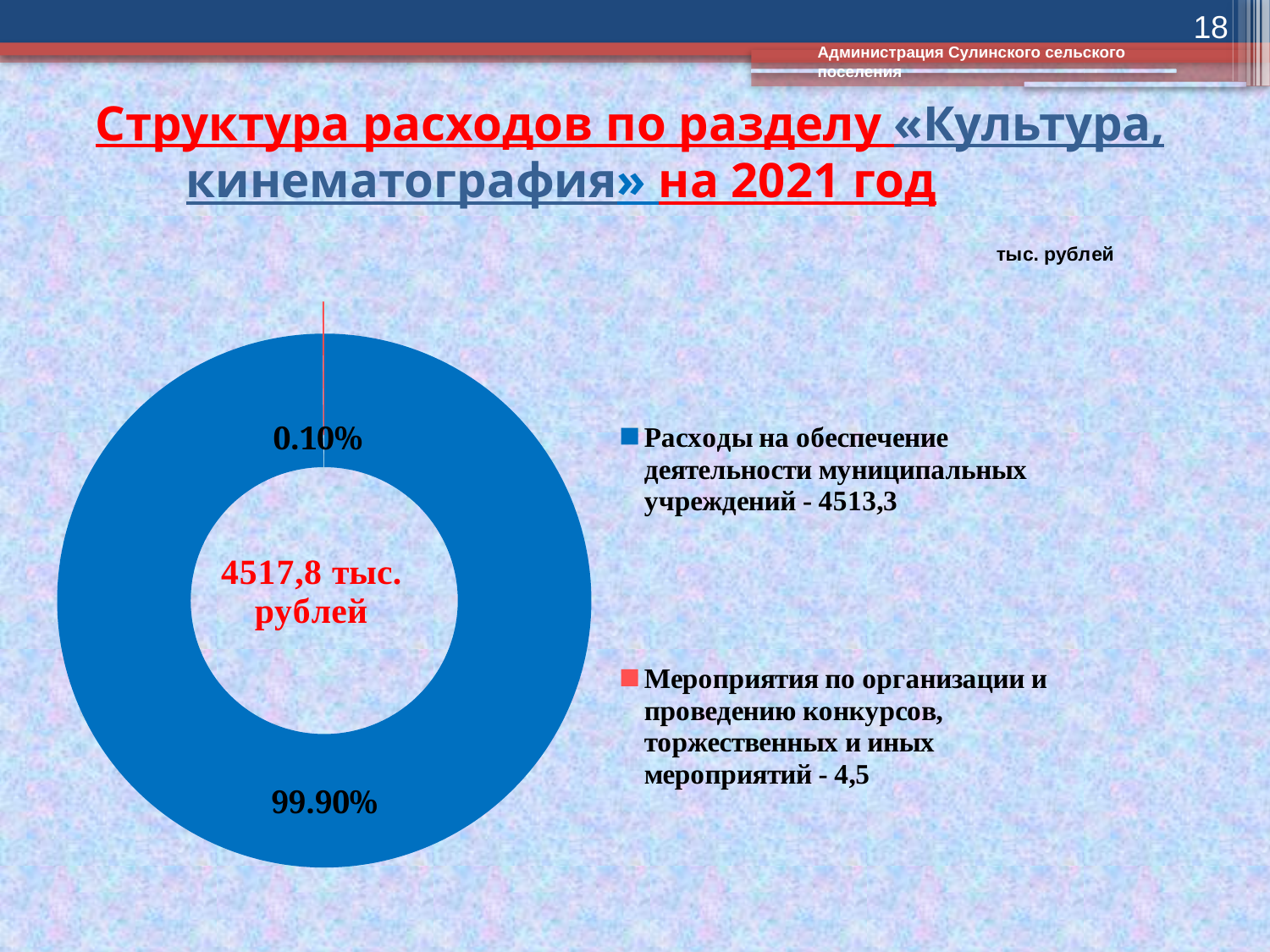
What share of the chart does "Расходы на обеспечение деятельности муниципальных учреждений" take? 99.90% How many categories does the chart's legend list? 2 What value is given in the legend for "Мероприятия по организации и проведению конкурсов, торжественных и иных мероприятий"? 4,5 What unit of measurement is indicated above the chart? тыс. рублей Which category has the largest share of the chart? Расходы на обеспечение деятельности муниципальных учреждений Which is larger: the value for "Расходы на обеспечение деятельности муниципальных учреждений" or for "Мероприятия по организации и проведению конкурсов, торжественных и иных мероприятий"? Расходы на обеспечение деятельности муниципальных учреждений What total amount is shown in the centre of the chart? 4517,8 тыс. рублей Which category has the smallest share of the chart? Мероприятия по организации и проведению конкурсов, торжественных и иных мероприятий What value is given in the legend for "Расходы на обеспечение деятельности муниципальных учреждений"? 4513,3 What share of the chart does "Мероприятия по организации и проведению конкурсов, торжественных и иных мероприятий" take? 0.10% What colour represents "Мероприятия по организации и проведению конкурсов, торжественных и иных мероприятий" in the chart? Red What kind of chart is shown on the slide? Doughnut (pie) chart